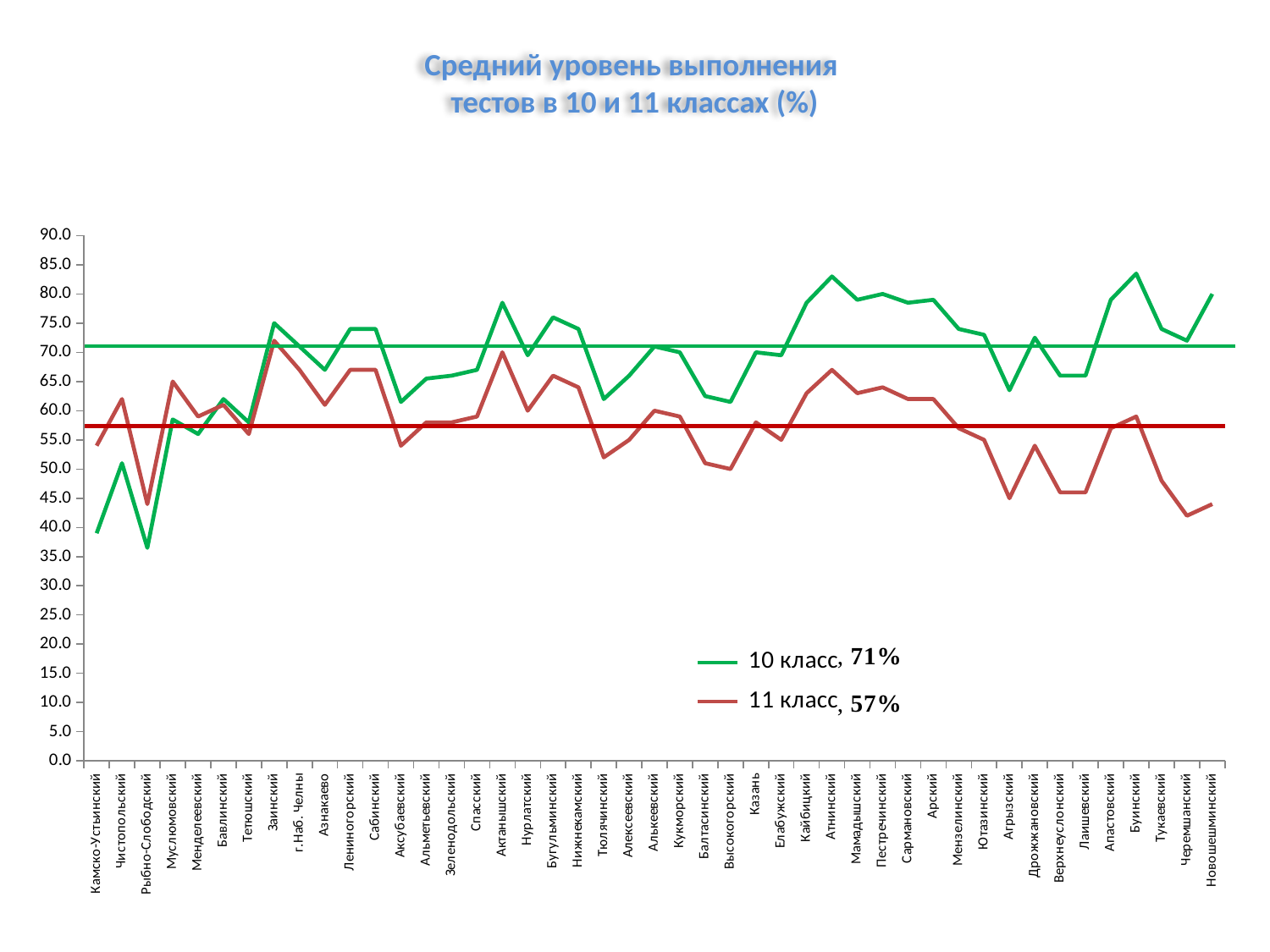
Which district has the lowest value for 10 класс? Рыбно-Слободский What kind of chart is shown on the slide? line chart Is the value for 10 класс in Атнинский greater or less than 80.0? greater How many series does the legend list? 2 How many districts (categories) are plotted along the x axis? 45 Is the value for 11 класс in Агрызский greater or less than 50.0? less What is the title of the chart? Средний уровень выполнения тестов в 10 и 11 классах (%) What average value is shown in the legend for 10 класс? 71% In Атнинский, which series has the larger value, 10 класс or 11 класс? 10 класс Is the value for 10 класс in Рыбно-Слободский greater or less than 40.0? less What average value is shown in the legend for 11 класс? 57% In Камско-Устьинский, which series has the larger value, 10 класс or 11 класс? 11 класс